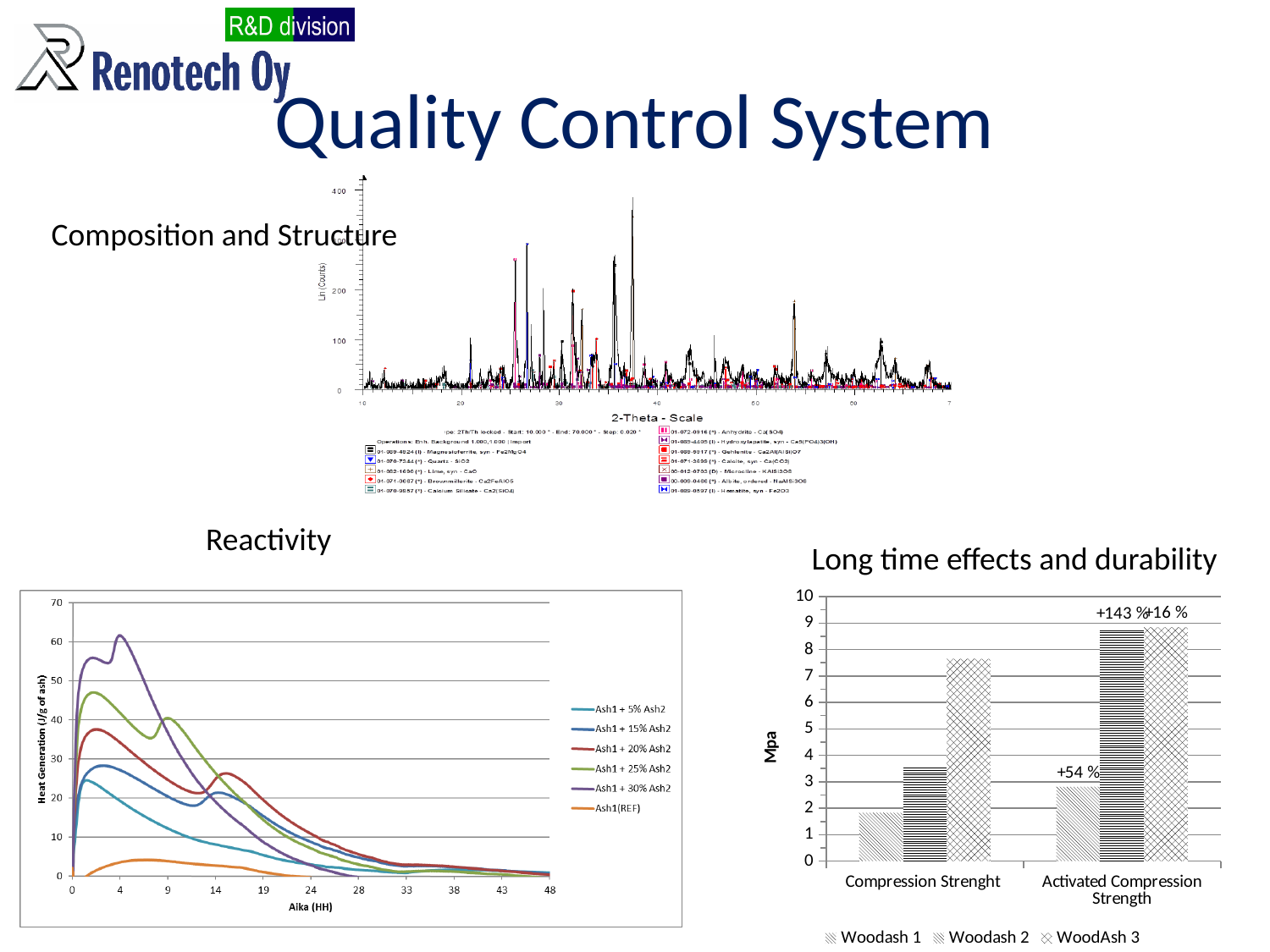
In the 'Long time effects and durability' chart, which series has the highest value for Compression Strenght? WoodAsh 3 In the 'Reactivity' chart, which series reaches the highest peak heat generation? Ash1 + 30% Ash2 In the 'Long time effects and durability' chart, what is the y-axis label? Mpa In the 'Long time effects and durability' chart, which series has the lowest value for Activated Compression Strength? Woodash 1 In the 'Long time effects and durability' chart, is the value of WoodAsh 3 for Compression Strenght greater or less than 7? greater In the 'Long time effects and durability' chart, what percentage label is shown above the Woodash 1 bar for Activated Compression Strength? +54 % How many series does the legend of the 'Long time effects and durability' chart list? 3 In the 'Long time effects and durability' chart, is the value of Woodash 1 for Compression Strenght greater or less than 2? less How many categories are shown on the x axis of the 'Long time effects and durability' chart? 2 How many series does the legend of the 'Reactivity' line chart list? 6 In the 'Reactivity' chart, which series has the lowest heat generation throughout? Ash1(REF) What type of chart is the 'Long time effects and durability' chart? bar chart